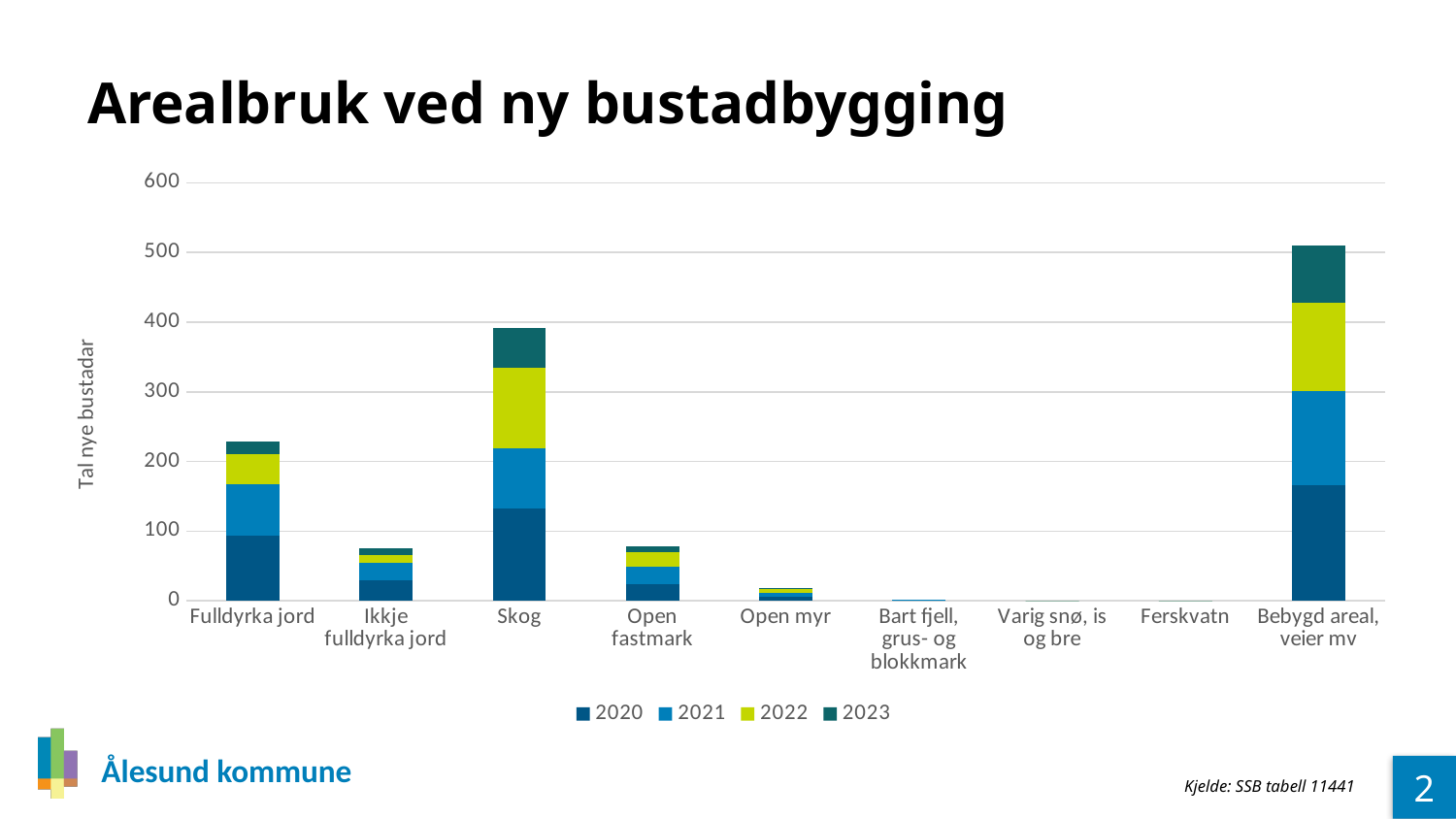
Is the total value for Ikkje fulldyrka jord greater or less than 100? less Is the total value for Skog greater or less than 300? greater How many categories are shown on the x axis? 9 Which has a larger total, Skog or Fulldyrka jord? Skog Is the total value for Bebygd areal, veier mv greater or less than 400? greater How many series does the legend list? 4 Which has a larger total, Open fastmark or Open myr? Open fastmark What is the title of the chart? Arealbruk ved ny bustadbygging What is the label of the y axis? Tal nye bustadar What type of chart is shown on the slide? Stacked bar chart Which category has the highest total stacked bar? Bebygd areal, veier mv